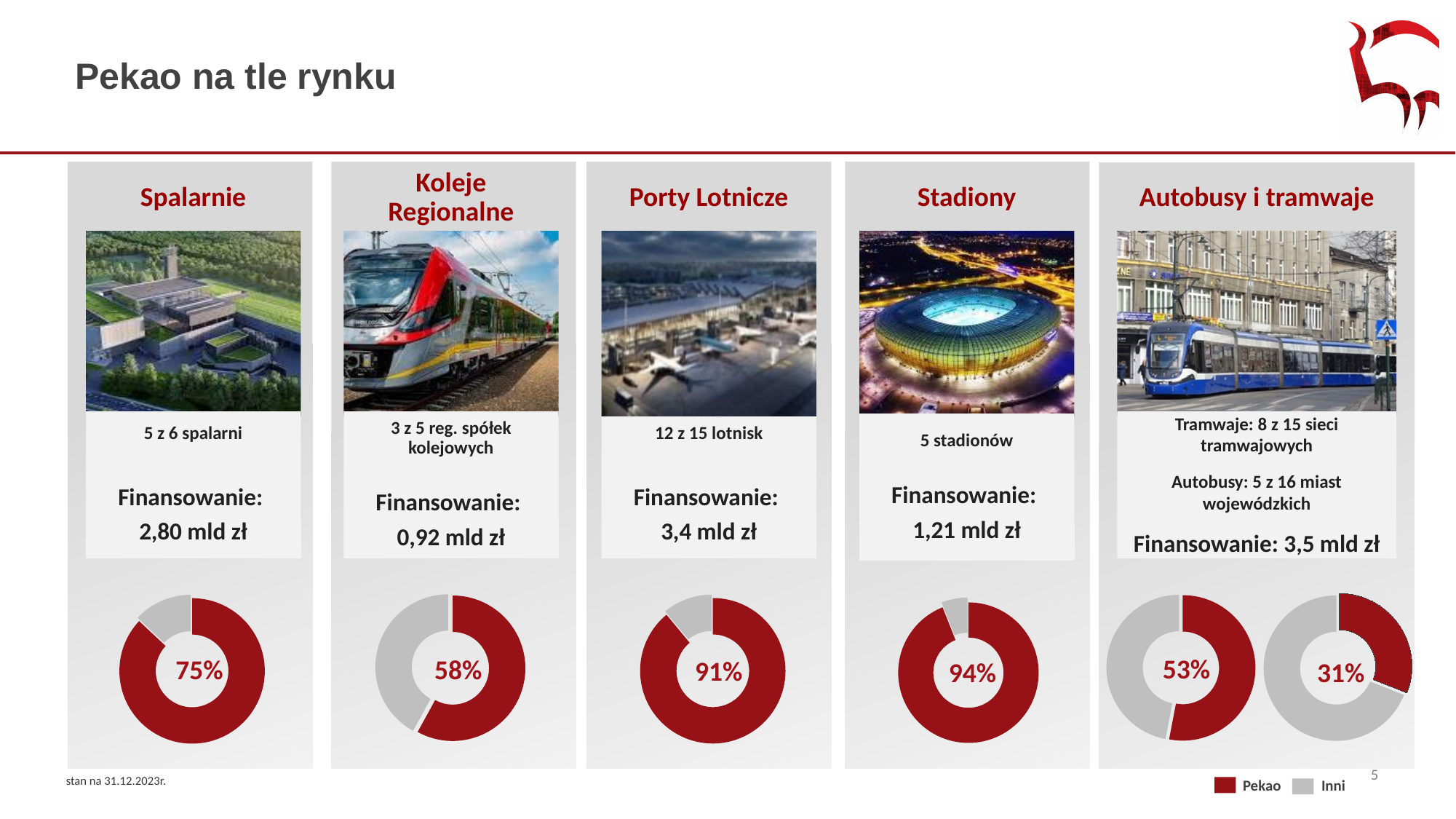
What is the difference between the Pekao share in the Stadiony donut chart and the Koleje Regionalne donut chart? 36 percentage points Which sector's donut chart shows the highest Pekao share on the slide? Stadiony How many donut charts are shown on the slide? 6 Which donut chart on the slide shows the lowest Pekao share? The right donut under Autobusy i tramwaje (31%) In the donut chart under Koleje Regionalne, what share does Pekao hold? 58% Under Autobusy i tramwaje, what Pekao share is shown in the left donut chart? 53% Which is larger: the Pekao share in the Porty Lotnicze donut chart or in the Spalarnie donut chart? Porty Lotnicze In the donut chart under Porty Lotnicze, what share does Pekao hold? 91% In the donut chart under Spalarnie, what share does Pekao hold? 75% In the donut chart under Stadiony, what share does Pekao hold? 94% What are the two legend entries for the donut charts on the slide? Pekao and Inni Under Autobusy i tramwaje, what Pekao share is shown in the right donut chart? 31%